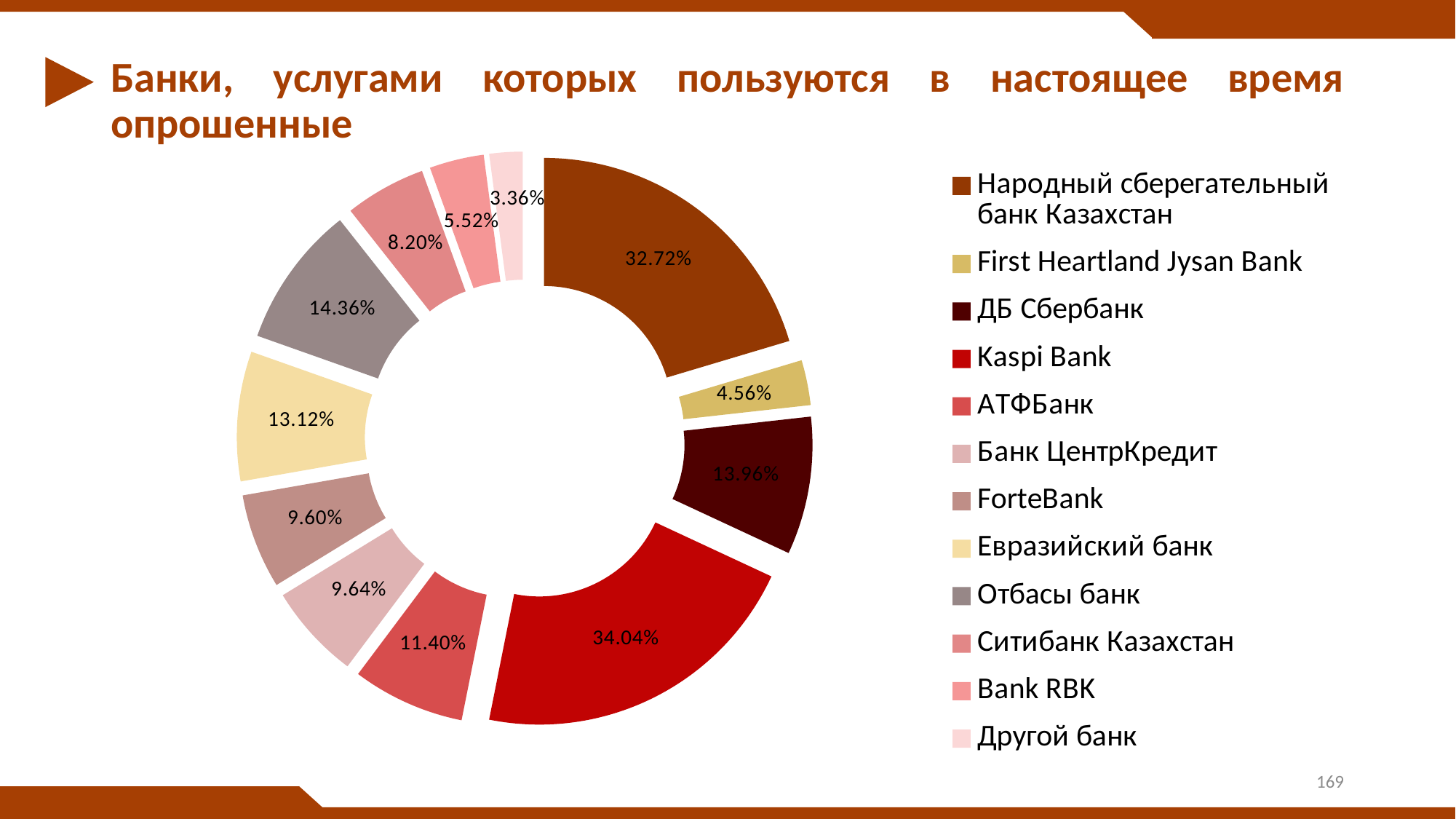
What type of chart is shown on the slide? Doughnut (pie) chart What percentage is shown for First Heartland Jysan Bank? 4.56% What percentage is shown for Kaspi Bank? 34.04% What percentage is shown for Евразийский банк? 13.12% Which bank has the smallest slice in the chart? Другой банк What is the difference between the values for Ситибанк Казахстан and Bank RBK? 2.68% What is the difference between the values for Kaspi Bank and Народный сберегательный банк Казахстан? 1.32% Which bank has the largest slice in the chart? Kaspi Bank What percentage is shown for Отбасы банк? 14.36% How many banks (categories) are shown in the chart? 12 What percentage is shown for Народный сберегательный банк Казахстан? 32.72% Which is larger, the value for ДБ Сбербанк or the value for АТФБанк? ДБ Сбербанк